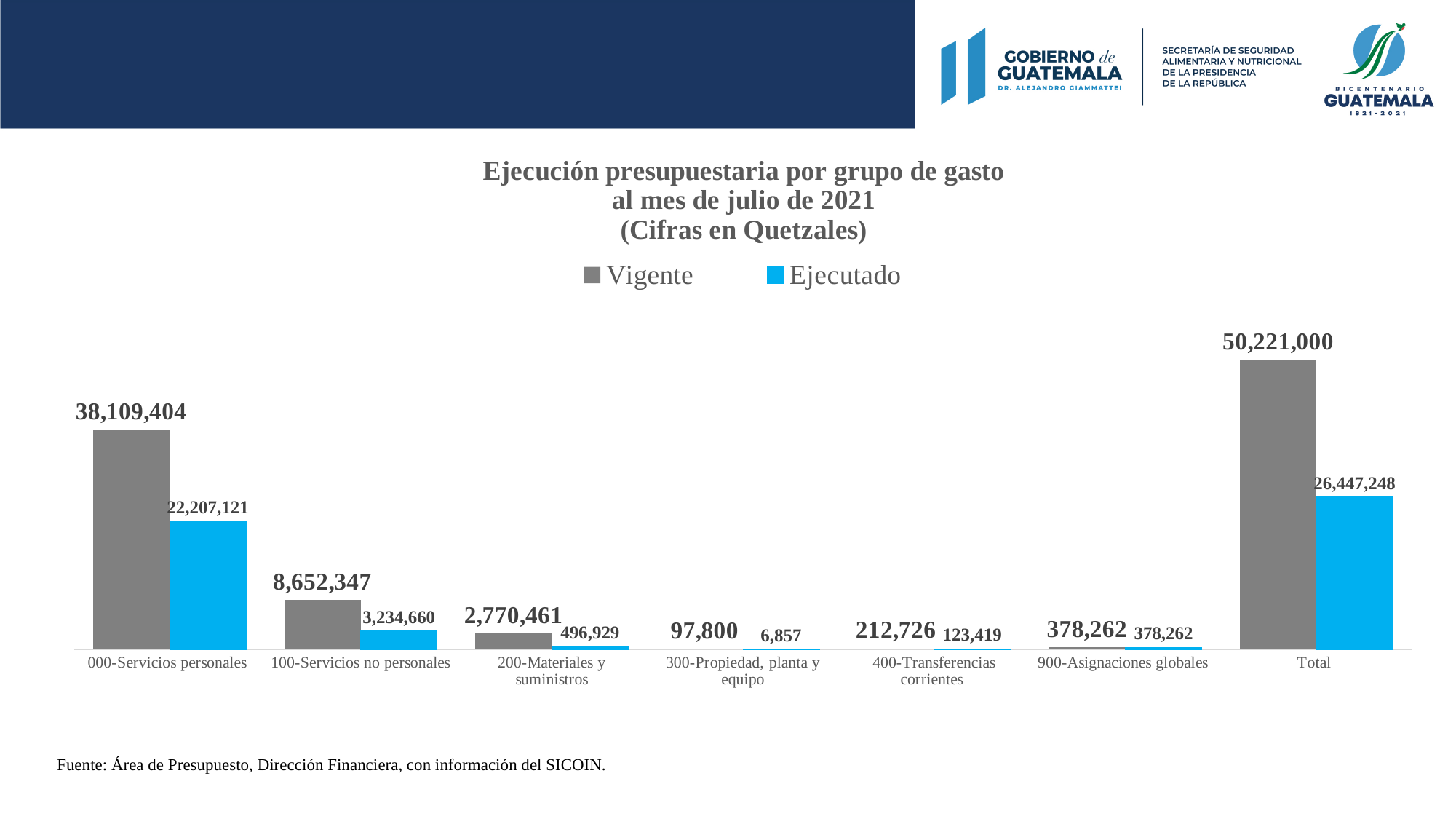
What is the Ejecutado value for 300-Propiedad, planta y equipo? 6,857 Which category has the highest Ejecutado value? Total What is the Vigente value for 000-Servicios personales? 38,109,404 What type of chart is shown on the slide? Bar chart Which is larger for 200-Materiales y suministros, the Vigente value or the Ejecutado value? Vigente Which category has the lowest Vigente value? 300-Propiedad, planta y equipo What is the Vigente value for 400-Transferencias corrientes? 212,726 How many categories are shown on the x axis? 7 What is the difference between the Vigente and Ejecutado values for Total? 23,773,752 How many series does the legend list? 2 What is the Ejecutado value for 100-Servicios no personales? 3,234,660 What colour are the Ejecutado bars? Blue